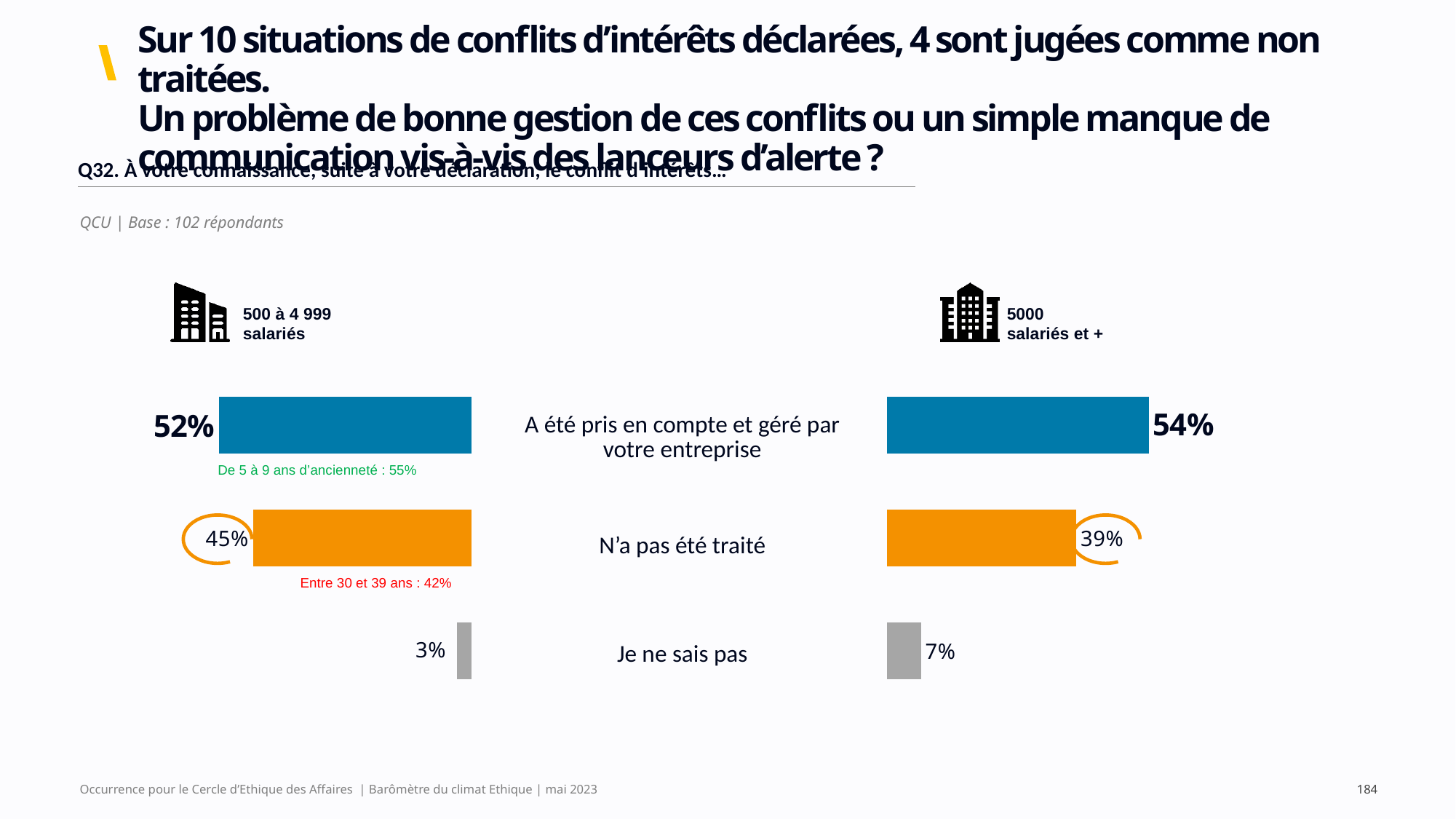
In the chart for companies with 500 à 4 999 salariés, what is the value for "Je ne sais pas"? 3% In the chart for companies with 500 à 4 999 salariés, what is the total of the three values shown? 100% In the chart for companies with 5000 salariés et +, which category has the highest value? A été pris en compte et géré par votre entreprise In the chart for companies with 5000 salariés et +, what is the value for "N'a pas été traité"? 39% What kind of chart is used to show the results for companies with 5000 salariés et +? Bar chart In the chart for companies with 500 à 4 999 salariés, what is the value for "A été pris en compte et géré par votre entreprise"? 52% What is the difference between the "N'a pas été traité" values for companies with 500 à 4 999 salariés and companies with 5000 salariés et +? 6 points (45% vs 39%) In the chart for companies with 500 à 4 999 salariés, which category has the lowest value? Je ne sais pas In the chart for companies with 5000 salariés et +, what is the value for "Je ne sais pas"? 7% How many categories are shown in the chart for companies with 500 à 4 999 salariés? 3 Which is larger: the "A été pris en compte et géré par votre entreprise" value for companies with 500 à 4 999 salariés or for companies with 5000 salariés et +? 5000 salariés et + What colour are the bars for "N'a pas été traité" in both charts? Orange